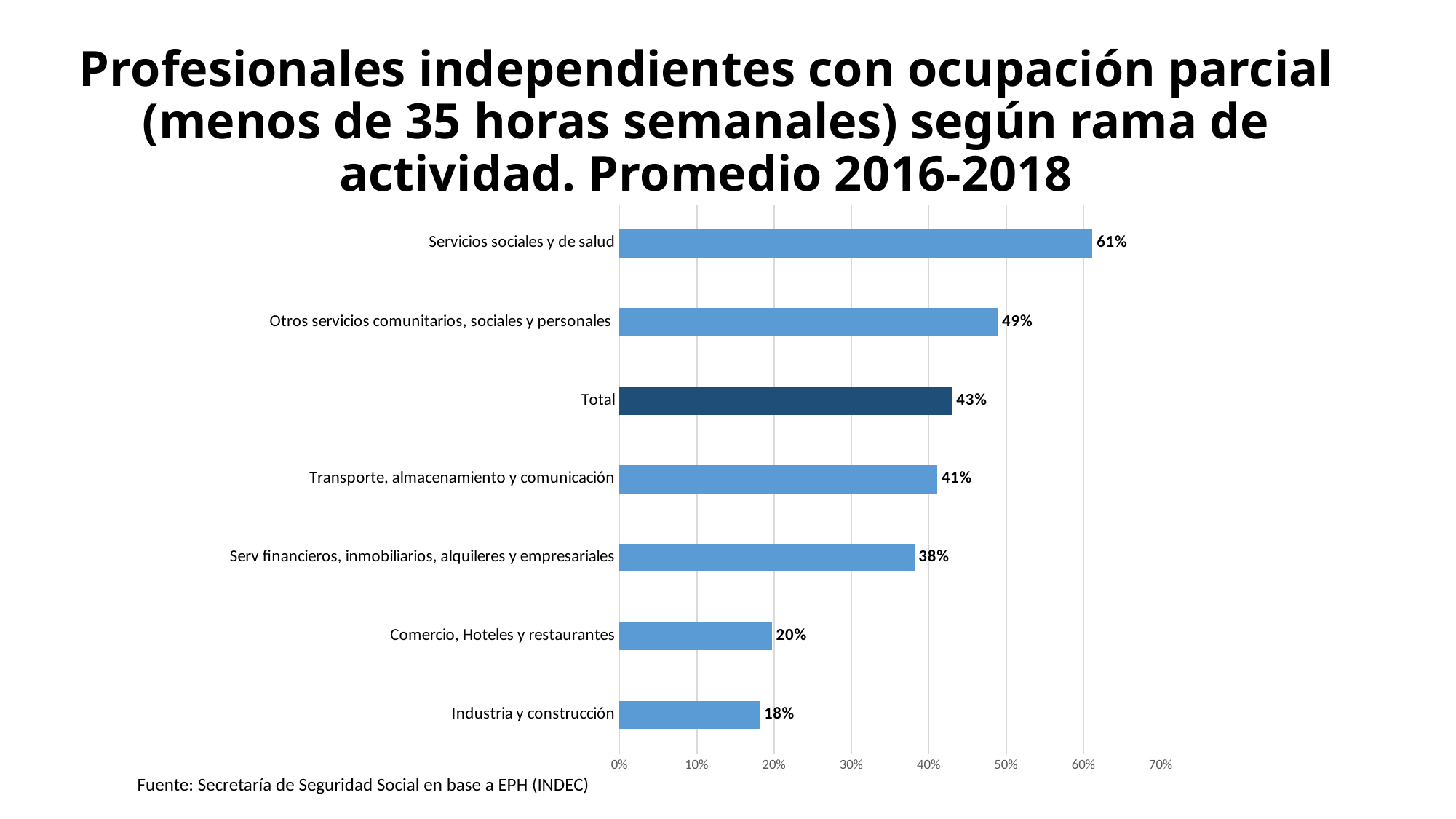
Which is larger: Serv financieros, inmobiliarios, alquileres y empresariales or Comercio, Hoteles y restaurantes? Serv financieros, inmobiliarios, alquileres y empresariales What is the value for Transporte, almacenamiento y comunicación? 41% Is the value for Industria y construcción greater or less than 20%? less How many categories are shown in the chart? 7 What kind of chart is shown on the slide? bar chart Which bar is shown in a darker blue colour than the others? Total What is the difference between Servicios sociales y de salud and Otros servicios comunitarios, sociales y personales? 12% Which category has the highest value? Servicios sociales y de salud What is the value for Comercio, Hoteles y restaurantes? 20% What is the value for Servicios sociales y de salud? 61% What is the value for Total? 43% Which category has the lowest value? Industria y construcción